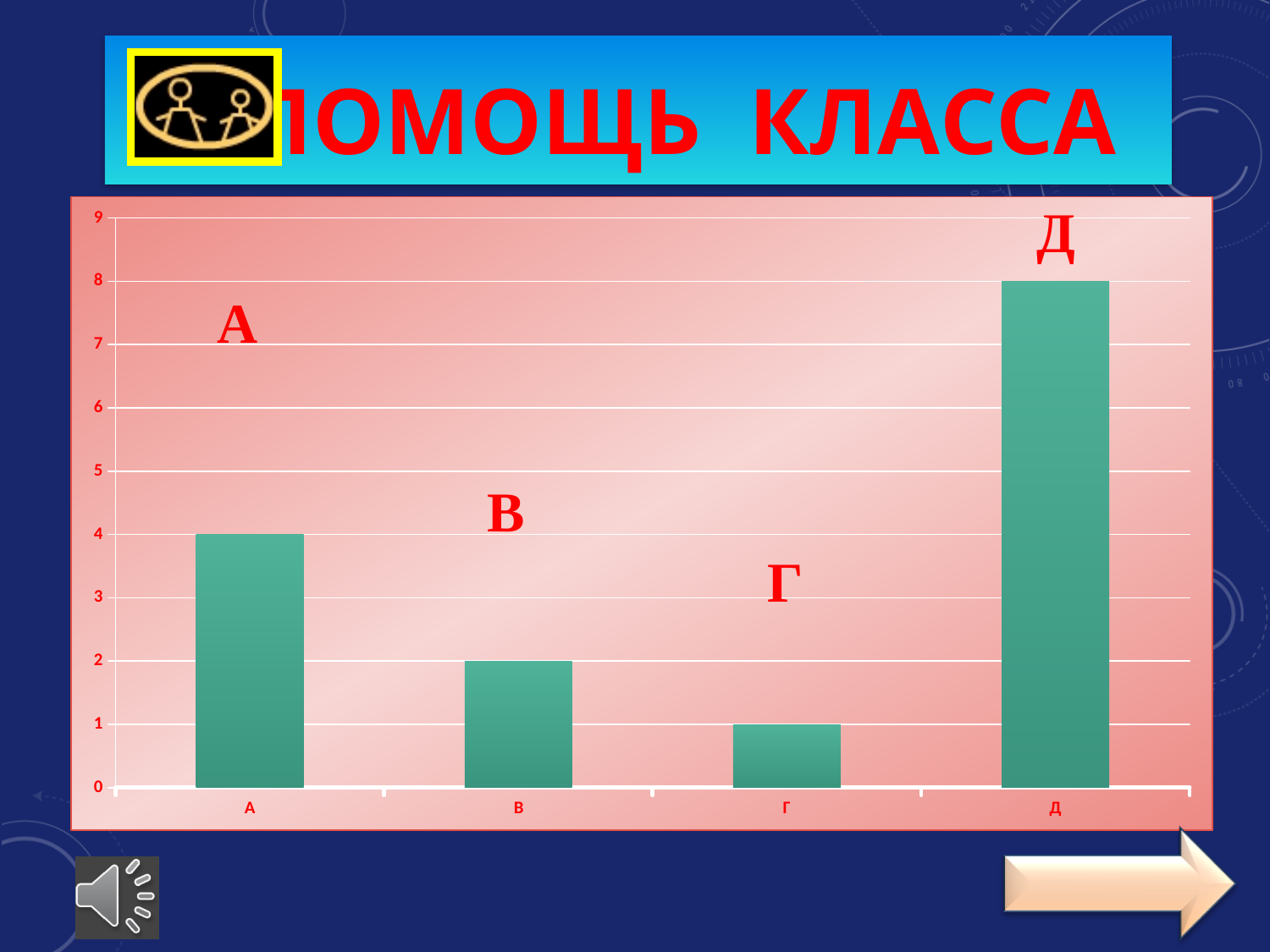
What is the value of the bar for category В? 2 Which is larger, the value for А or the value for В? А What is the value of the bar for category Д? 8 What is the value of the bar for category Г? 1 How many categories are shown on the x axis of the chart? 4 What type of chart is shown on the slide? bar chart Is the value for Д greater or less than 5? greater What is the value of the bar for category А? 4 Which category has the lowest bar? Г What is the difference between the values for Д and А? 4 Which category has the highest bar? Д What is the highest value shown on the vertical axis of the chart? 9